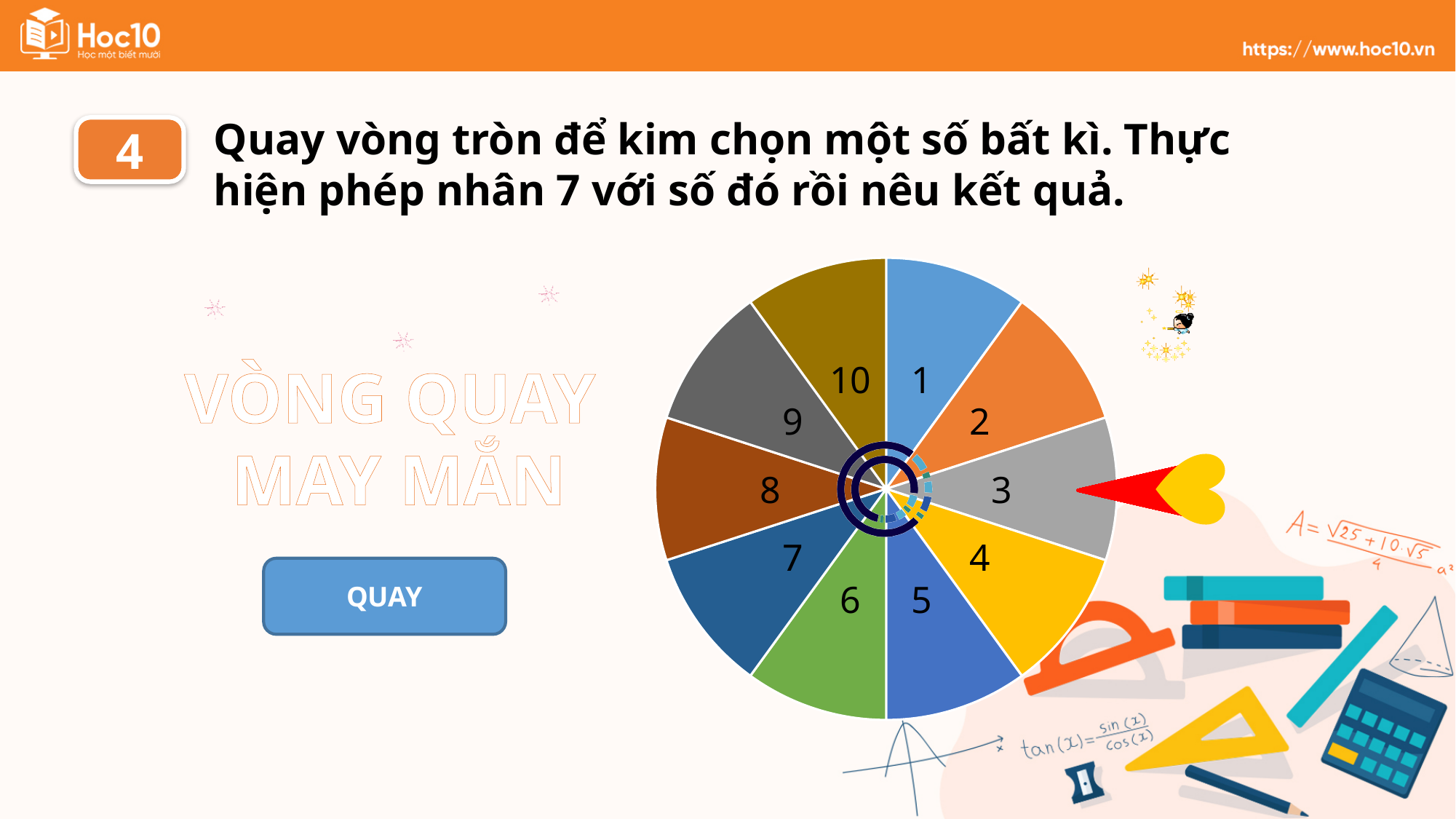
What is the largest number printed on the wheel? 10 What kind of chart is the wheel on the slide drawn as? pie chart How many segments does the wheel on the slide have? 10 What is the label of the segment directly counter-clockwise from the segment labelled 1? 10 Which number on the wheel is the red pointer pointing to? 3 What colour is the segment labelled 4 on the wheel? yellow What colour is the segment labelled 6 on the wheel? green What is the label of the segment directly clockwise from the segment labelled 1? 2 What is the smallest number printed on the wheel? 1